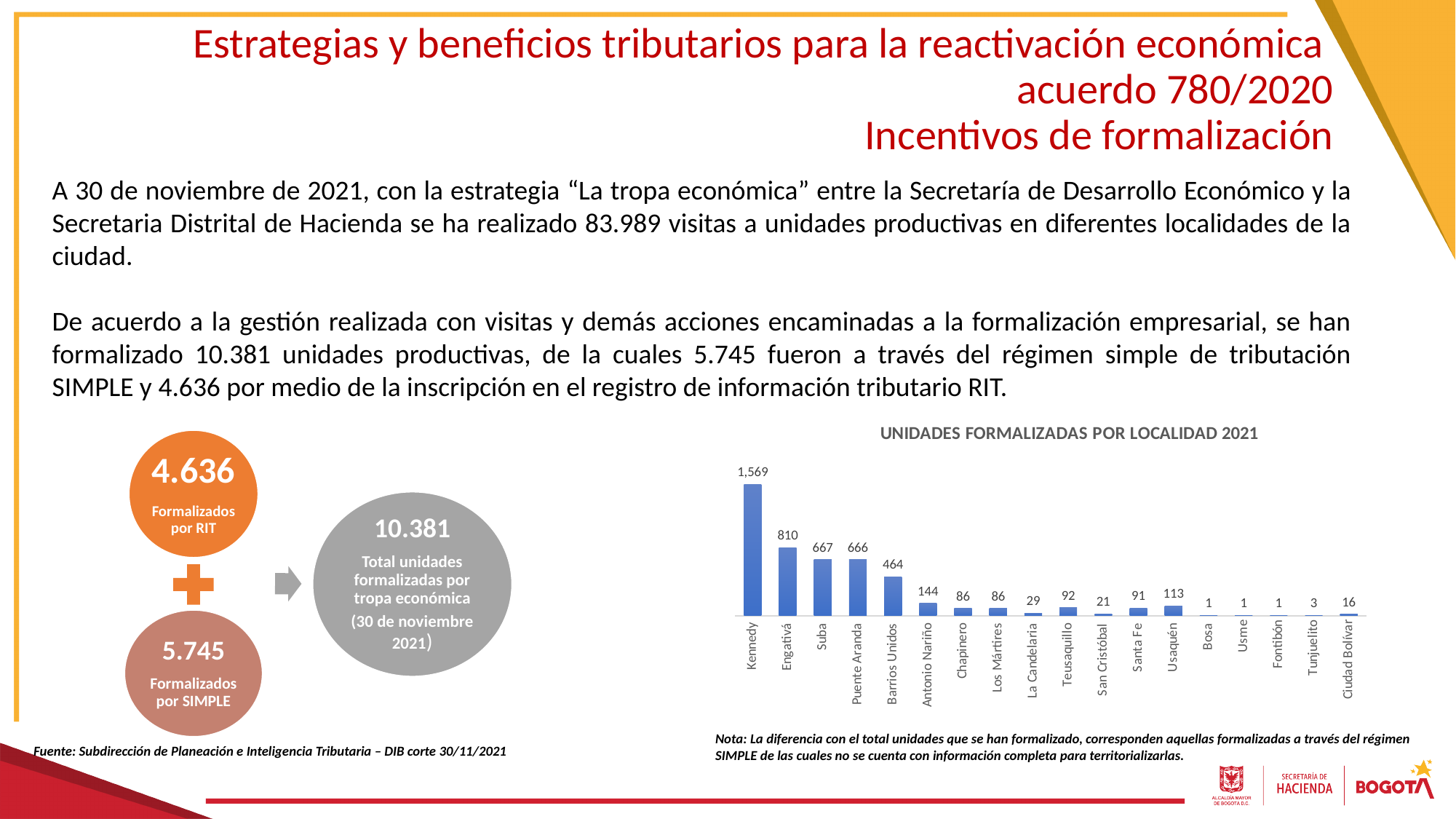
What is the title of the bar chart on the slide? UNIDADES FORMALIZADAS POR LOCALIDAD 2021 In the chart 'UNIDADES FORMALIZADAS POR LOCALIDAD 2021', what is the value for Kennedy? 1,569 What kind of chart is 'UNIDADES FORMALIZADAS POR LOCALIDAD 2021'? Bar chart In the chart 'UNIDADES FORMALIZADAS POR LOCALIDAD 2021', what is the difference between the values for Kennedy and Engativá? 759 In the chart 'UNIDADES FORMALIZADAS POR LOCALIDAD 2021', what is the difference between the values for Suba and Puente Aranda? 1 How many localities are shown in the chart 'UNIDADES FORMALIZADAS POR LOCALIDAD 2021'? 18 In the chart 'UNIDADES FORMALIZADAS POR LOCALIDAD 2021', what is the value for Barrios Unidos? 464 In the chart 'UNIDADES FORMALIZADAS POR LOCALIDAD 2021', what is the value for Engativá? 810 In the chart 'UNIDADES FORMALIZADAS POR LOCALIDAD 2021', which is larger, the value for Antonio Nariño or the value for Usaquén? Antonio Nariño In the chart 'UNIDADES FORMALIZADAS POR LOCALIDAD 2021', which locality has the highest value? Kennedy In the chart 'UNIDADES FORMALIZADAS POR LOCALIDAD 2021', what is the value for Ciudad Bolívar? 16 In the chart 'UNIDADES FORMALIZADAS POR LOCALIDAD 2021', what is the value for Usaquén? 113